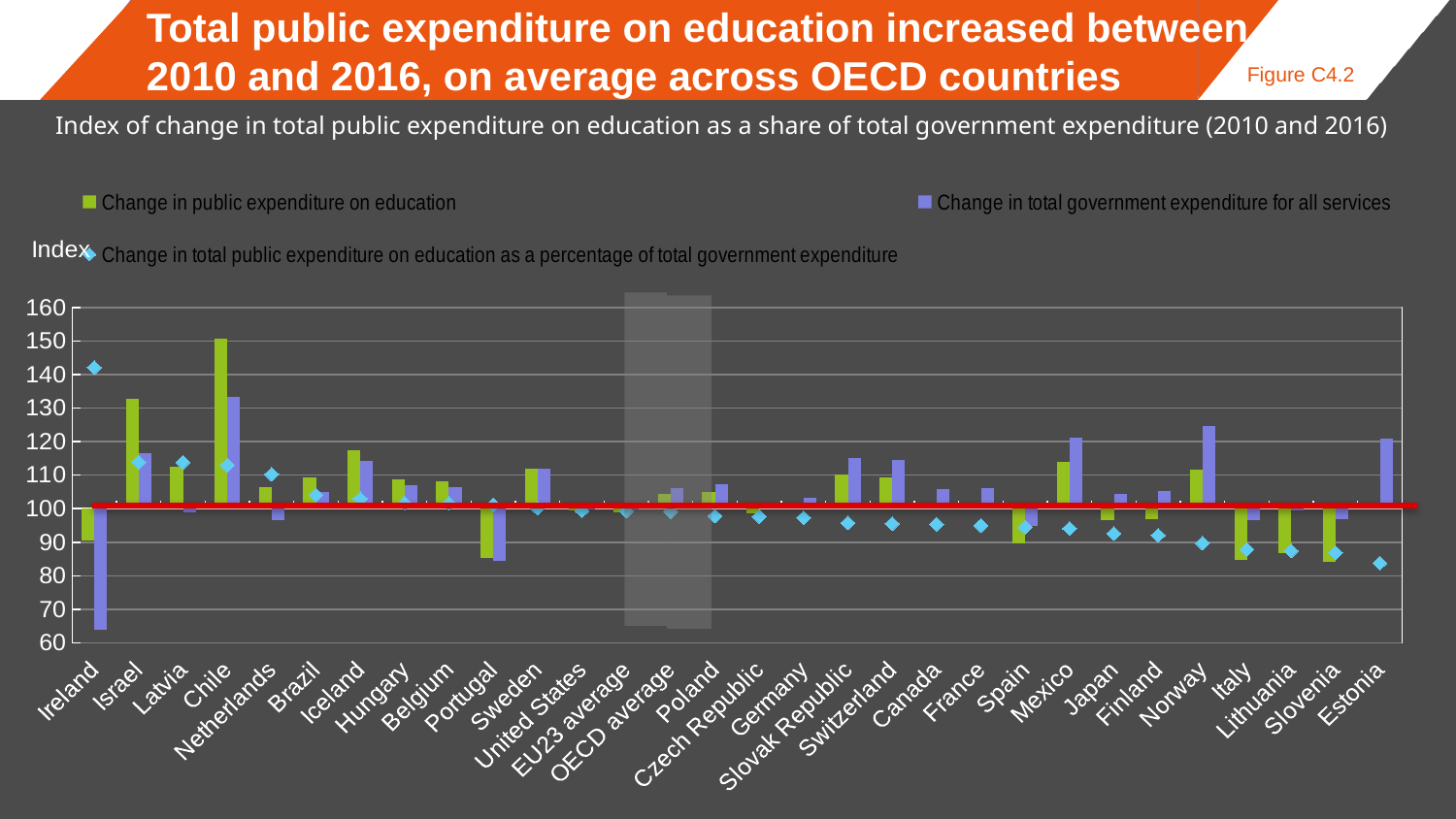
Is the change in total public expenditure on education as a percentage of total government expenditure for Estonia greater or less than 90? less Which has the larger change in public expenditure on education, Chile or Israel? Chile Is the change in total public expenditure on education as a percentage of total government expenditure for Ireland greater or less than 130? greater Which country has the highest green bar (change in public expenditure on education)? Chile What kind of chart is used to show the change in public expenditure on education and the change in total government expenditure? Bar chart Is the change in public expenditure on education for Chile greater or less than 140? greater How many series does the chart's legend list? 3 Which country has the lowest purple bar (change in total government expenditure for all services)? Ireland Which has the larger change in public expenditure on education, Portugal or Sweden? Sweden How many countries or averages are shown along the x axis of the chart? 30 At what index value is the horizontal red reference line drawn on the chart? 100